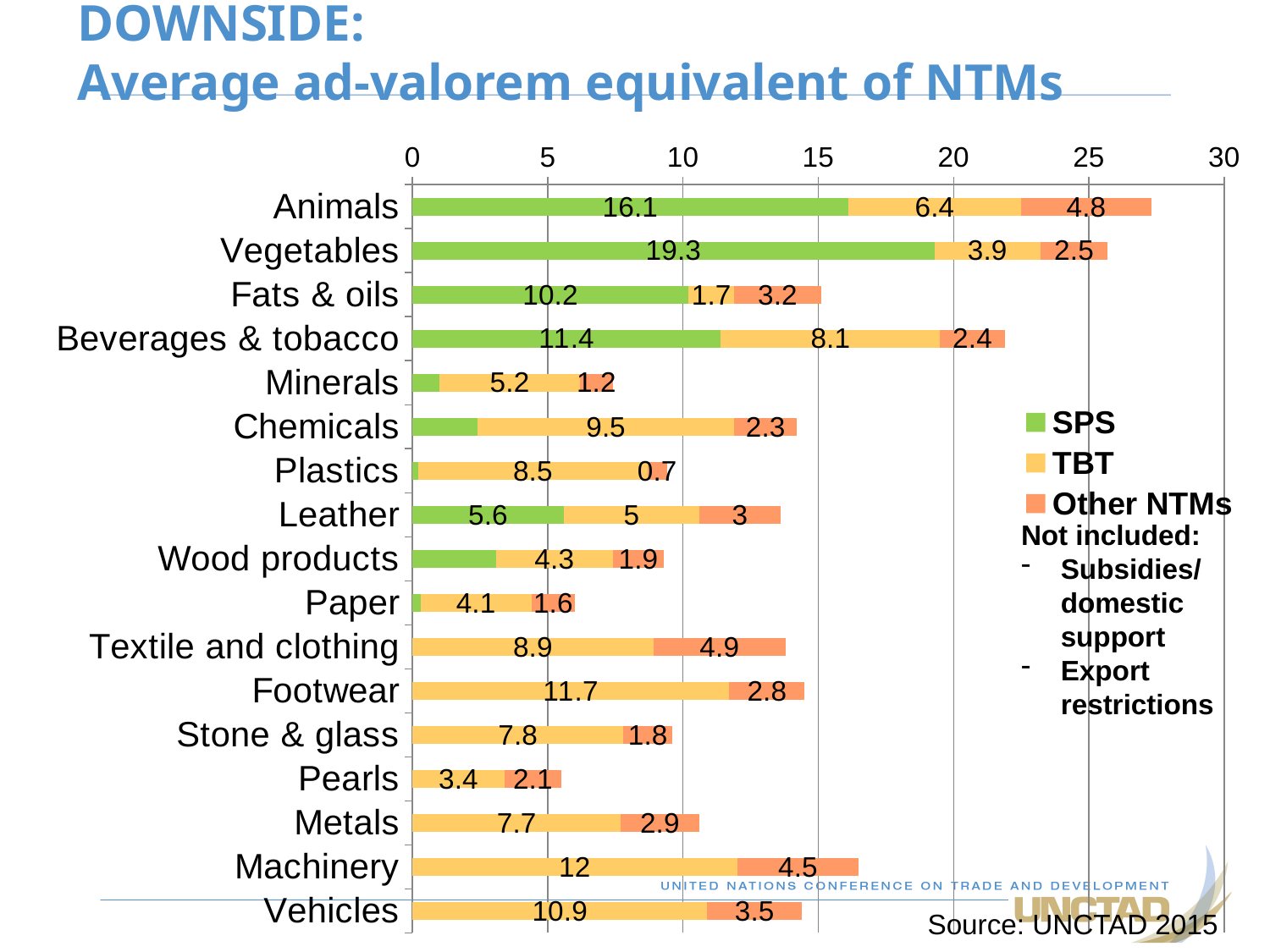
What kind of chart is shown on the slide? Stacked bar chart How many series does the legend list? 3 What is the difference between the TBT value for Animals and the TBT value for Vegetables? 2.5 How many categories are shown on the chart? 17 Is the total bar length for Animals greater or less than 25? greater What is the SPS value for Vegetables? 19.3 Which is larger, the TBT value for Footwear or the TBT value for Machinery? Machinery What is the TBT value for Beverages & tobacco? 8.1 Which category has the lowest labelled Other NTMs value? Plastics What is the Other NTMs value for Machinery? 4.5 What is the total of the stacked bar for Animals? 27.3 Which category has the highest SPS value? Vegetables